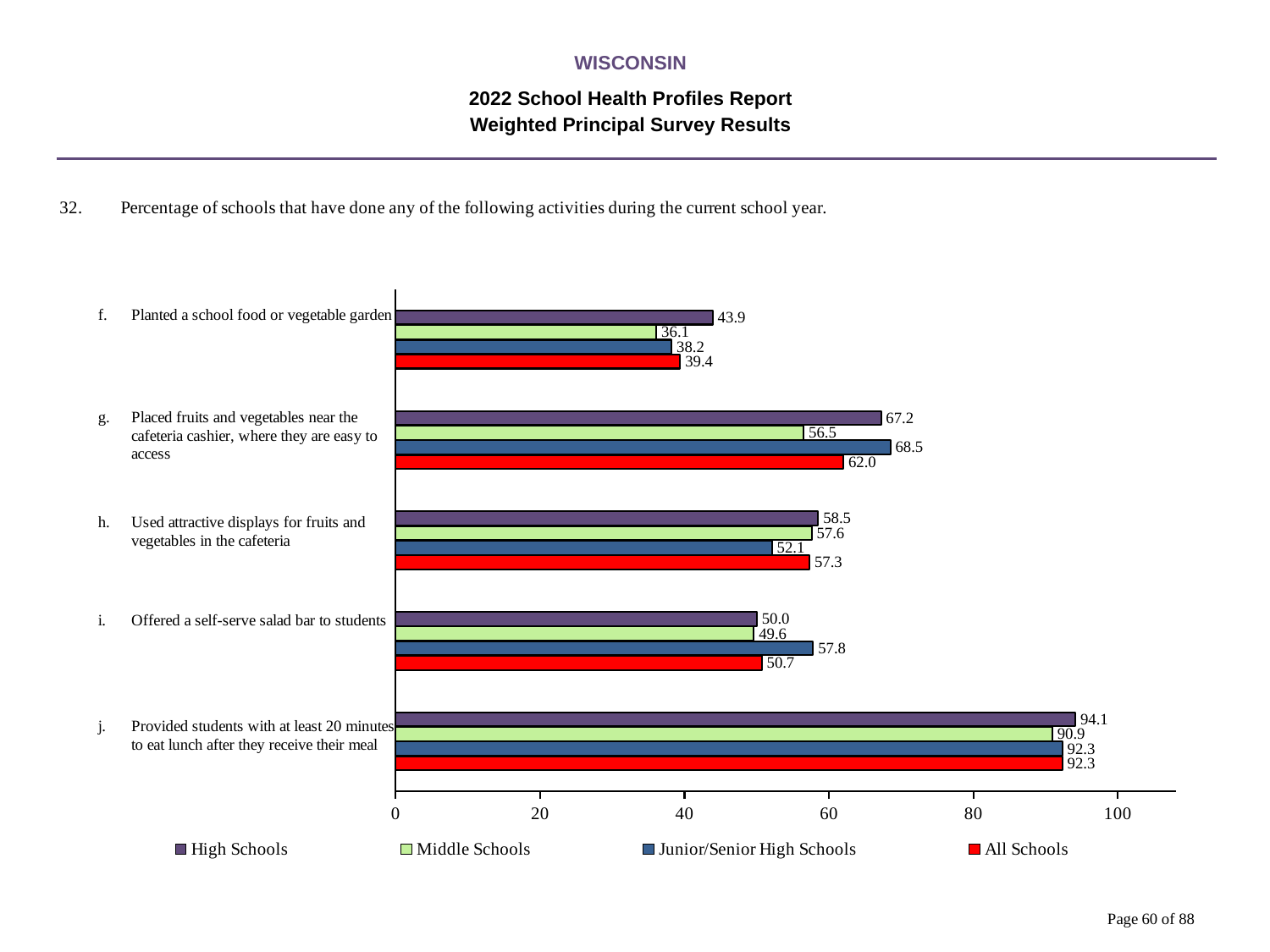
Is the All Schools value for 'Placed fruits and vegetables near the cafeteria cashier, where they are easy to access' greater or less than 60? greater How many series does the legend list? 4 What is the value for High Schools for 'Planted a school food or vegetable garden'? 43.9 Which series is shown in red in the legend? All Schools What is the value for All Schools for 'Offered a self-serve salad bar to students'? 50.7 Which activity has the highest value for Middle Schools? Provided students with at least 20 minutes to eat lunch after they receive their meal For 'Offered a self-serve salad bar to students', which is larger: the Junior/Senior High Schools value or the High Schools value? Junior/Senior High Schools Which activity has the lowest value for All Schools? Planted a school food or vegetable garden What is the difference between the High Schools and Middle Schools values for 'Planted a school food or vegetable garden'? 7.8 How many activities (categories) are shown in the chart? 5 What kind of chart is shown on the slide? Bar chart What is the value for Junior/Senior High Schools for 'Placed fruits and vegetables near the cafeteria cashier, where they are easy to access'? 68.5